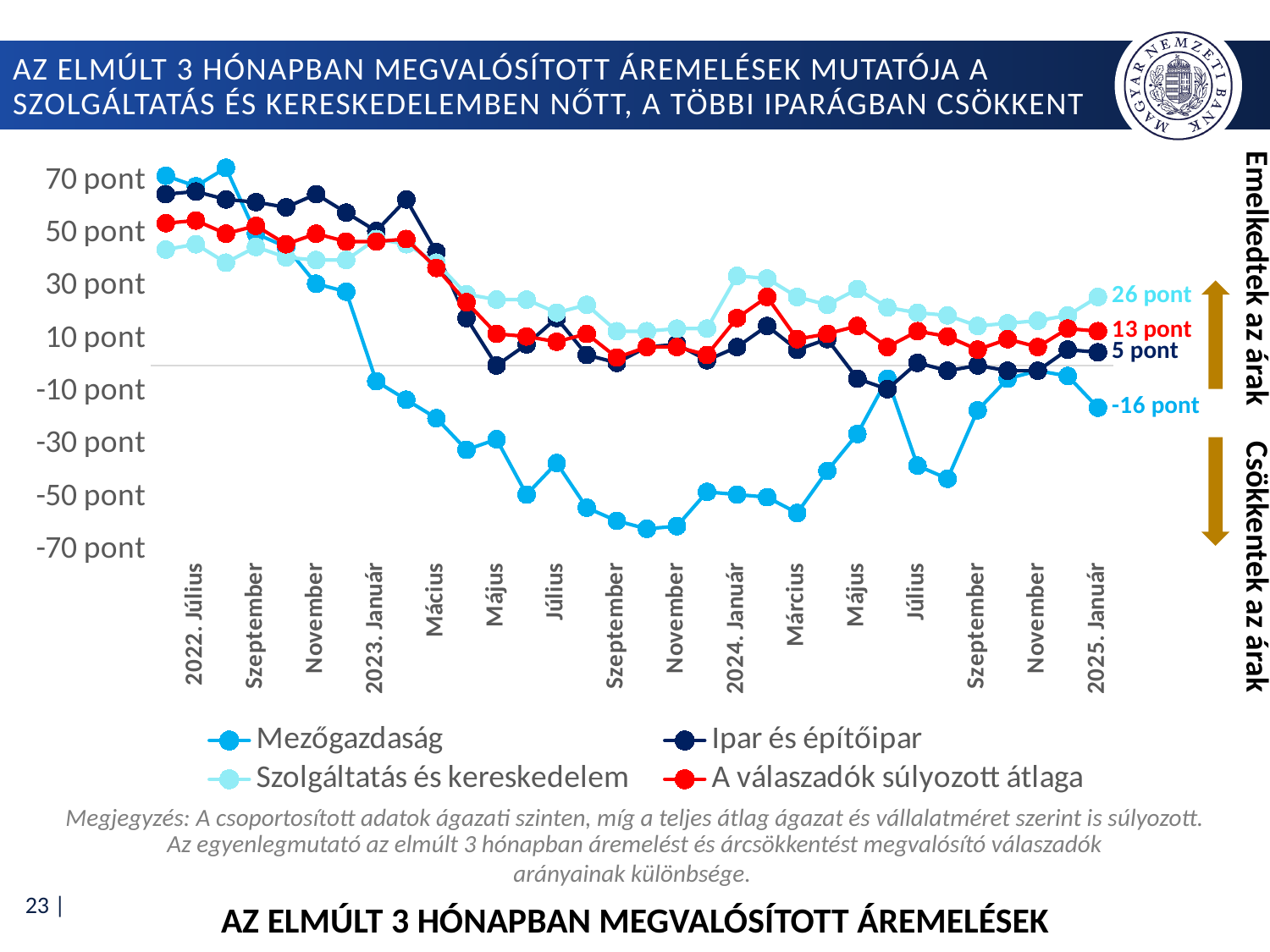
What is the value for A válaszadók súlyozott átlaga in 2025. Január? 13 pont What is the value for Szolgáltatás és kereskedelem in 2025. Január? 26 pont How many series does the legend list? 4 What is the value for Ipar és építőipar in 2025. Január? 5 pont Is the value for Mezőgazdaság in 2022. Július greater or less than 50 pont? greater What is the value for Mezőgazdaság in 2025. Január? -16 pont What kind of chart is shown on the slide? line chart What is the difference between the 2025. Január values of A válaszadók súlyozott átlaga and Ipar és építőipar? 8 pont What is the difference between the 2025. Január values of Szolgáltatás és kereskedelem and Mezőgazdaság? 42 pont Which series has the lowest value in 2025. Január? Mezőgazdaság In 2025. Január, which is larger: Ipar és építőipar or Mezőgazdaság? Ipar és építőipar Which series has the highest value in 2025. Január? Szolgáltatás és kereskedelem